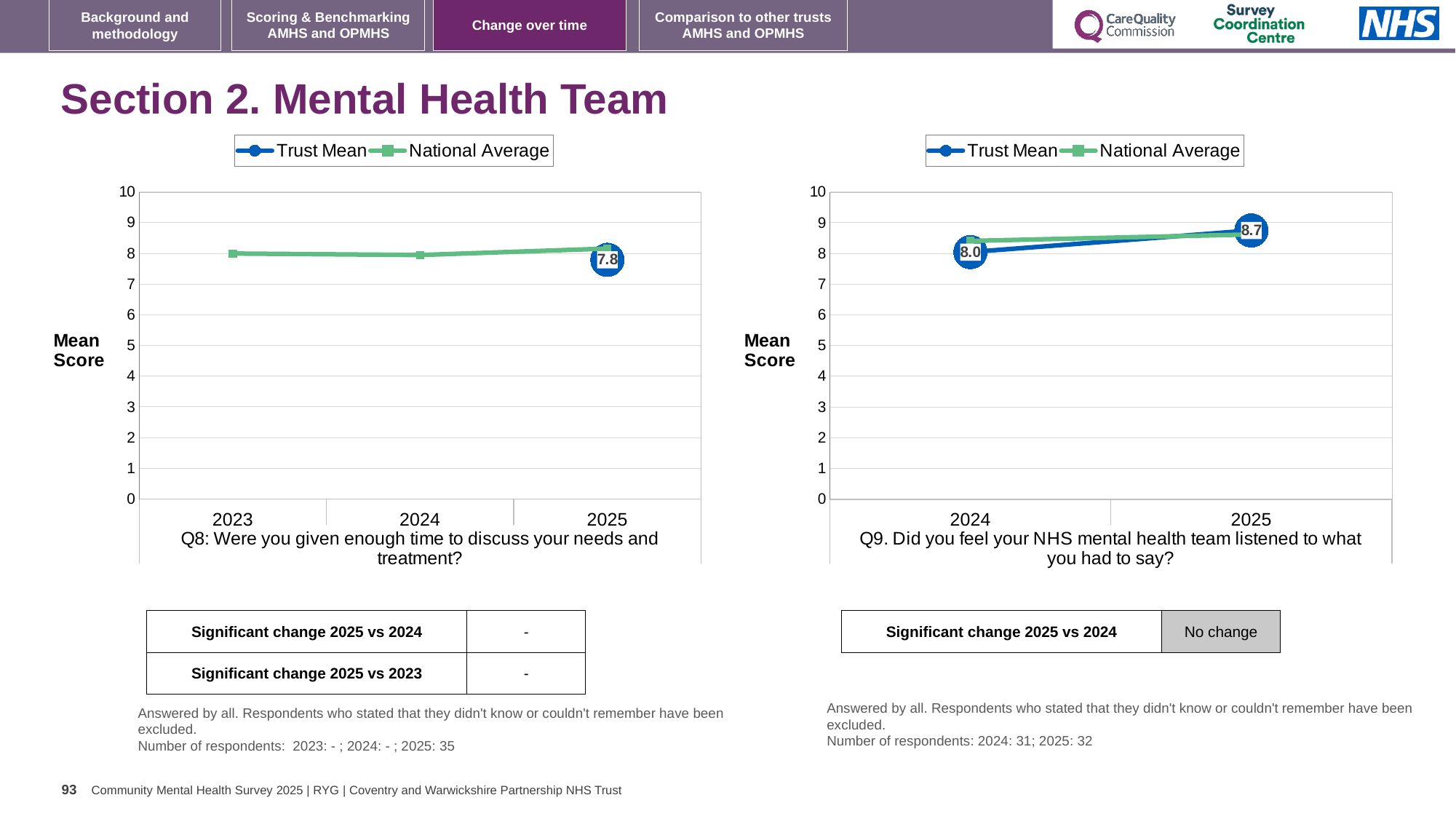
In the Q9 chart on the right, does the Trust Mean rise or fall from 2024 to 2025? rise What type of chart is the Q8 chart on the left? line chart In the Q9 chart on the right, what is the Trust Mean value for 2024? 8.0 What are the two series named in the legend of the Q8 chart on the left? Trust Mean and National Average In the Q9 chart on the right, what is the Trust Mean value for 2025? 8.7 In the Q9 chart on the right, is the Trust Mean higher in 2024 or 2025? 2025 In the Q9 chart on the right, by how much did the Trust Mean change from 2024 to 2025? 0.7 How many series does the legend of the Q9 chart on the right list? 2 How many years are shown on the x axis of the Q9 chart on the right? 2 In the Q8 chart on the left, is the National Average value for 2023 greater or less than 5? greater In the Q8 chart on the left, what is the Trust Mean value for 2025? 7.8 How many years are shown on the x axis of the Q8 chart on the left? 3